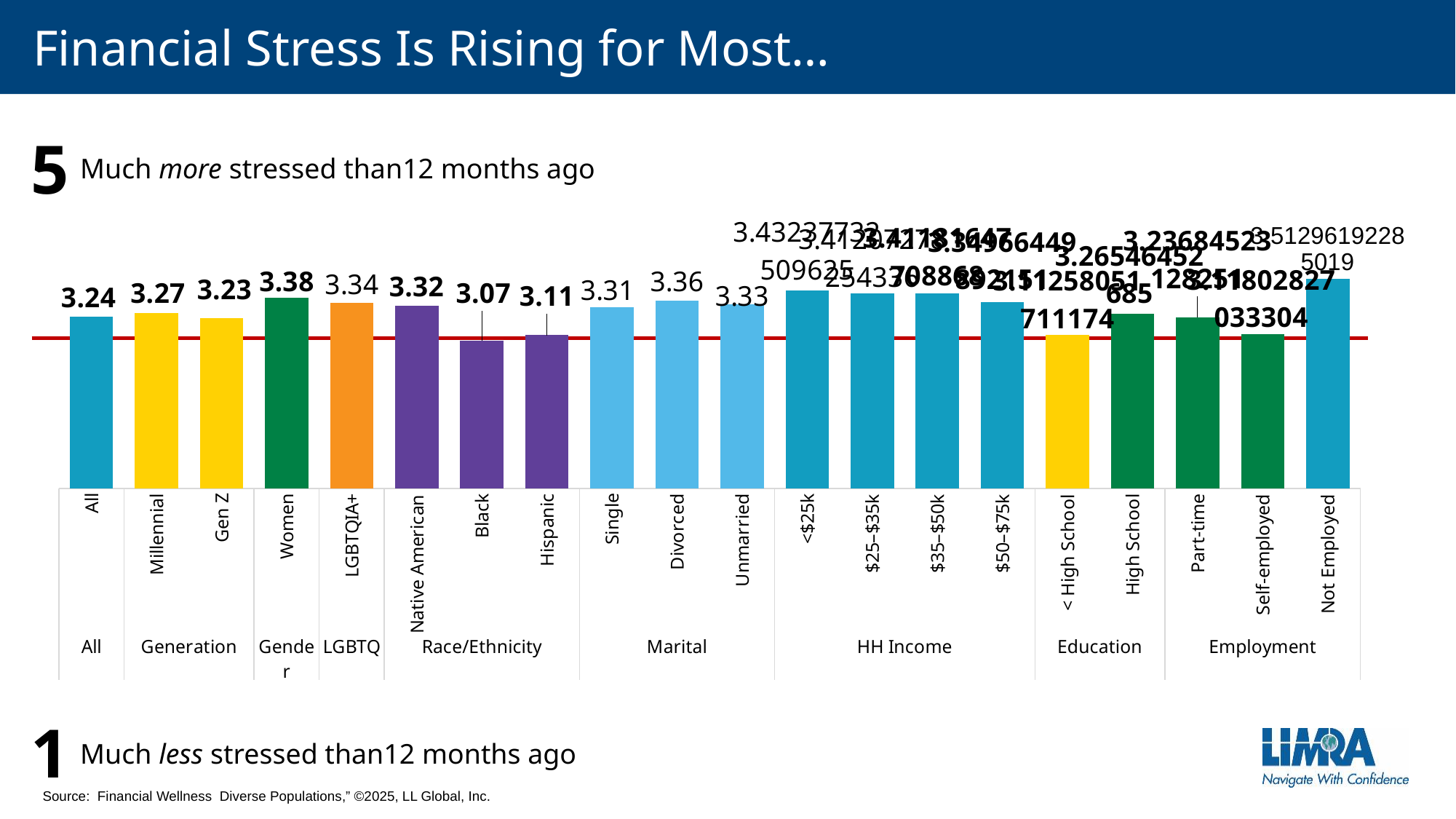
Which category has the tallest bar on the chart? Not Employed What is the difference between the values for Millennial and Gen Z? 0.04 What is the value for Black in the Race/Ethnicity group? 3.07 What is the value for Divorced? 3.36 What is the value for the All bar? 3.24 What is the difference between the values for Women and Black? 0.31 What kind of chart is shown on the slide? Bar chart How many bars are plotted on the chart? 20 Which is larger, the value for Divorced or the value for Single? Divorced What is the value for Women? 3.38 What is the value for LGBTQIA+? 3.34 Which category in the Race/Ethnicity group has the lowest value? Black